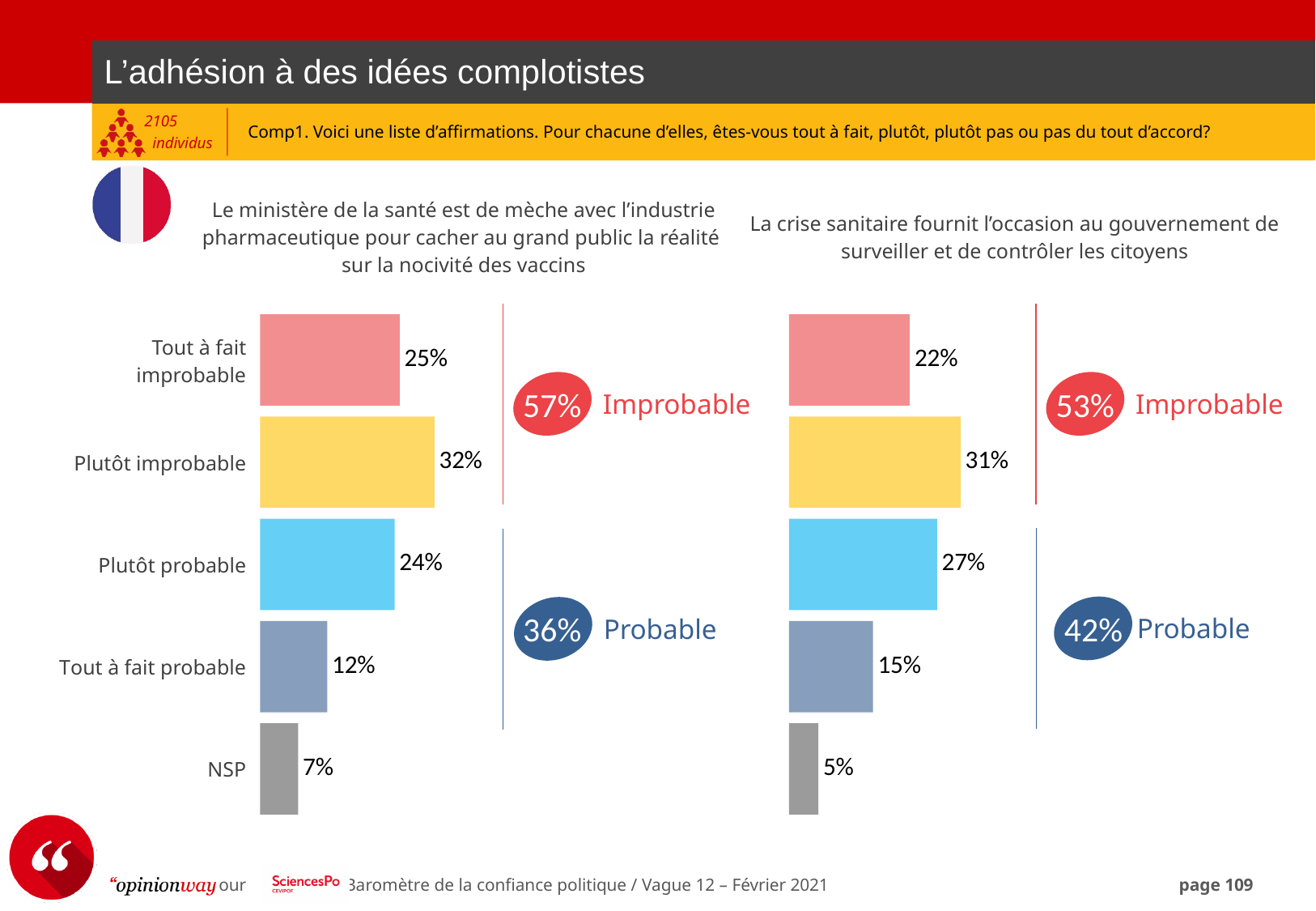
In the left chart (Le ministère de la santé est de mèche avec l'industrie pharmaceutique), what is the value for 'Plutôt improbable'? 32% In the right chart (La crise sanitaire), what is the value for 'Tout à fait probable'? 15% What type of chart is used on this slide? Bar chart How many categories are shown in the left chart (Le ministère de la santé)? 5 In the right chart (La crise sanitaire), which category has the lowest value? NSP In the left chart (Le ministère de la santé), what is the value for 'NSP'? 7% In the right chart (La crise sanitaire), what is the difference between 'Plutôt improbable' and 'Tout à fait improbable'? 9% In the right chart (La crise sanitaire fournit l'occasion au gouvernement de surveiller et de contrôler les citoyens), what is the value for 'Plutôt probable'? 27% In the right chart (La crise sanitaire), what combined percentage is shown for 'Probable'? 42% In the left chart (Le ministère de la santé), which category has the highest value? Plutôt improbable In the left chart (Le ministère de la santé), what is the difference between 'Plutôt improbable' and 'Tout à fait probable'? 20% Which is larger: 'Tout à fait improbable' in the left chart (Le ministère de la santé) or 'Tout à fait improbable' in the right chart (La crise sanitaire)? Left chart (25%)